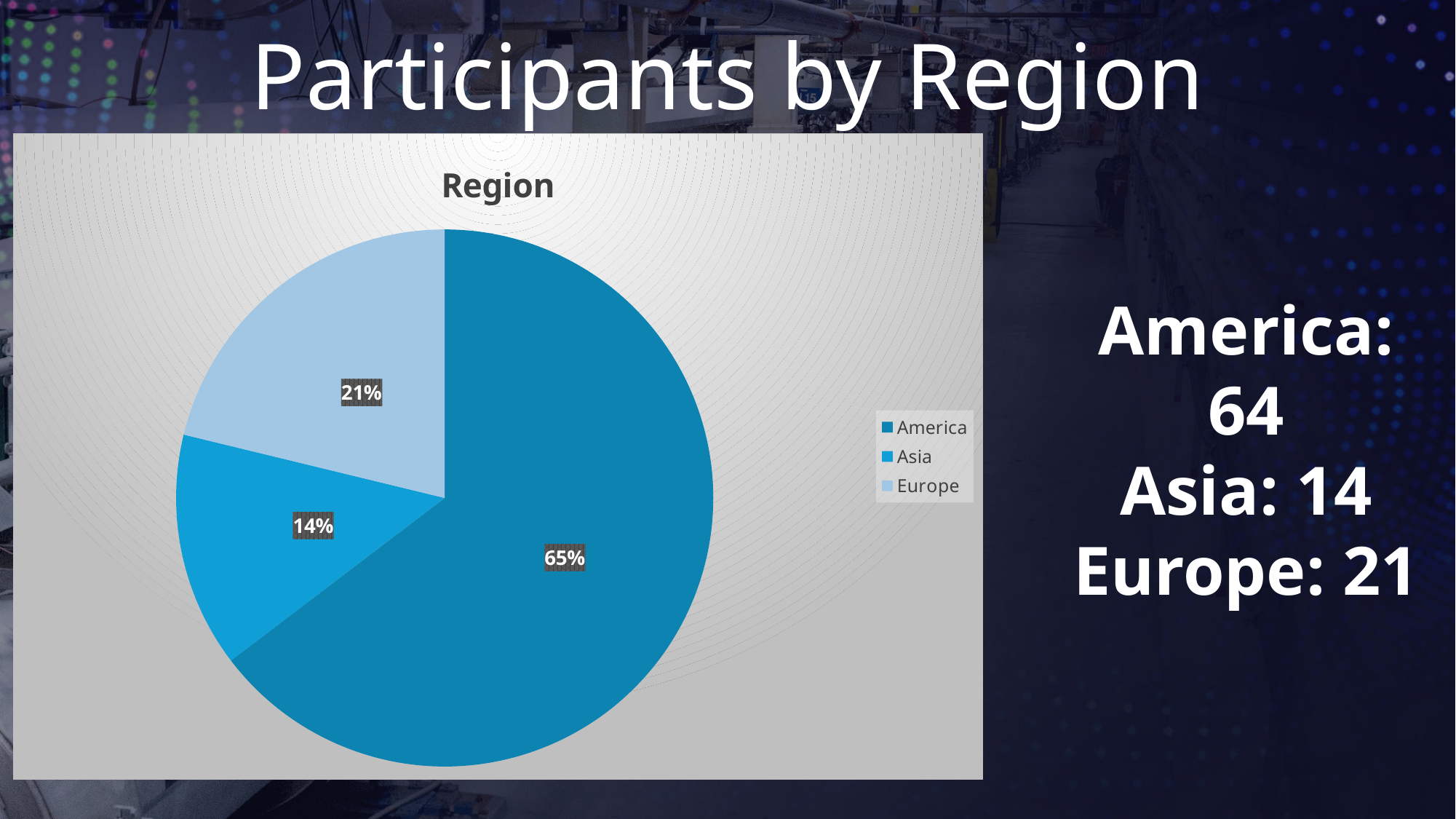
What is the difference in percentage points between the America slice and the Europe slice? 44 What is the title of the chart? Region How many slices does the pie chart have? 3 Which slice is larger, Europe or Asia? Europe What percentage share does the Asia slice have? 14% Which region has the largest slice of the pie? America Which region has the smallest slice of the pie? Asia What percentage share does the America slice have? 65% Which region is shown in the lightest blue colour in the legend? Europe What percentage share does the Europe slice have? 21% What kind of chart is shown on the slide? pie chart How many entries does the legend list? 3